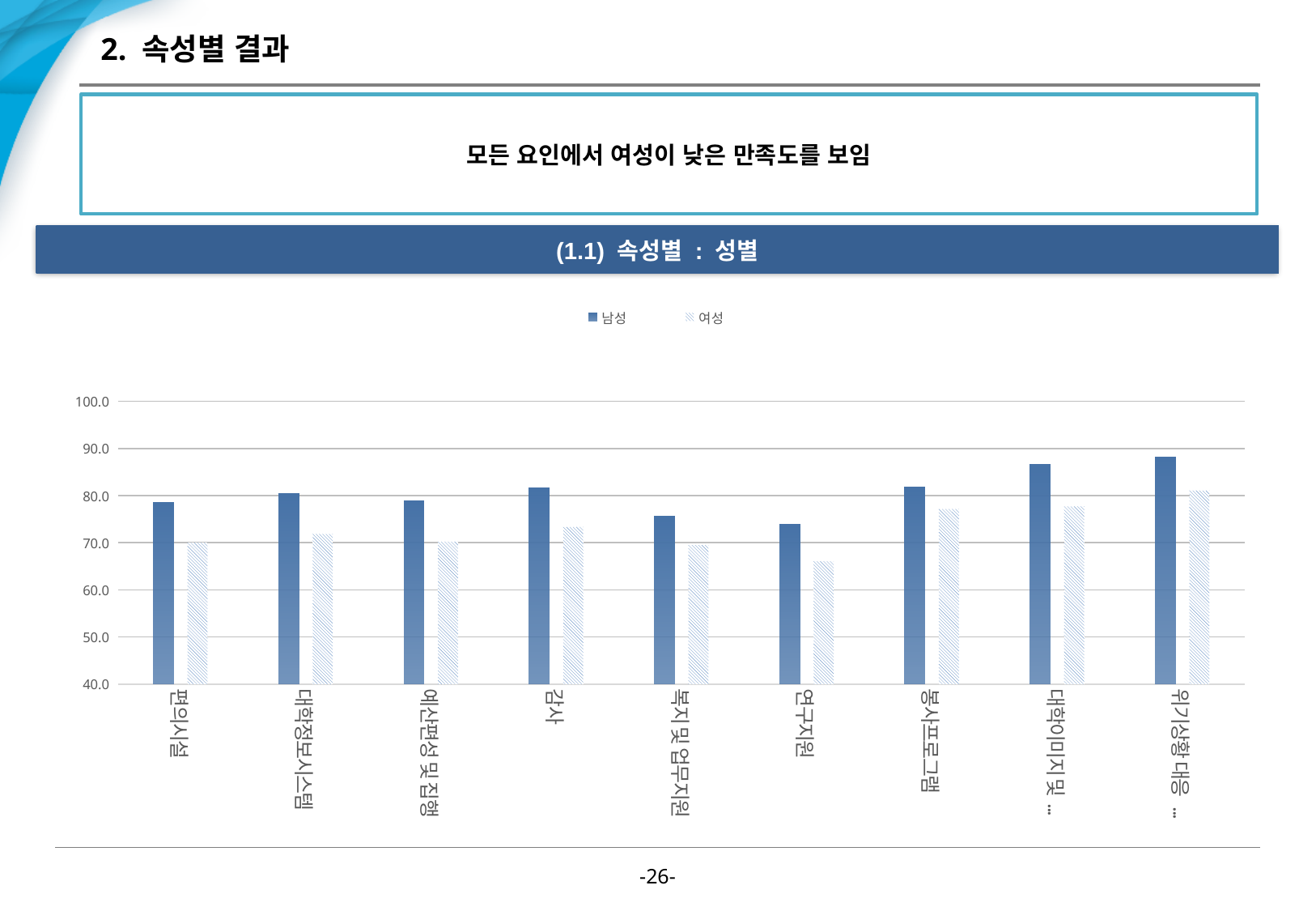
Is the value for 여성 in 봉사프로그램 greater or less than 70? greater How many categories are shown on the x axis? 9 What is the title shown in the blue band above the chart? (1.1) 속성별 : 성별 Which series has the higher value for 연구지원, 남성 or 여성? 남성 Is the value for 남성 in 편의시설 greater or less than 80? less What kind of chart is shown on the slide? bar chart How many series does the legend list? 2 Is the value for 여성 in 연구지원 greater or less than 70? less What are the two series named in the legend? 남성, 여성 Which category has the lowest value for the 여성 series? 연구지원 Which series has the lower value for 감사, 남성 or 여성? 여성